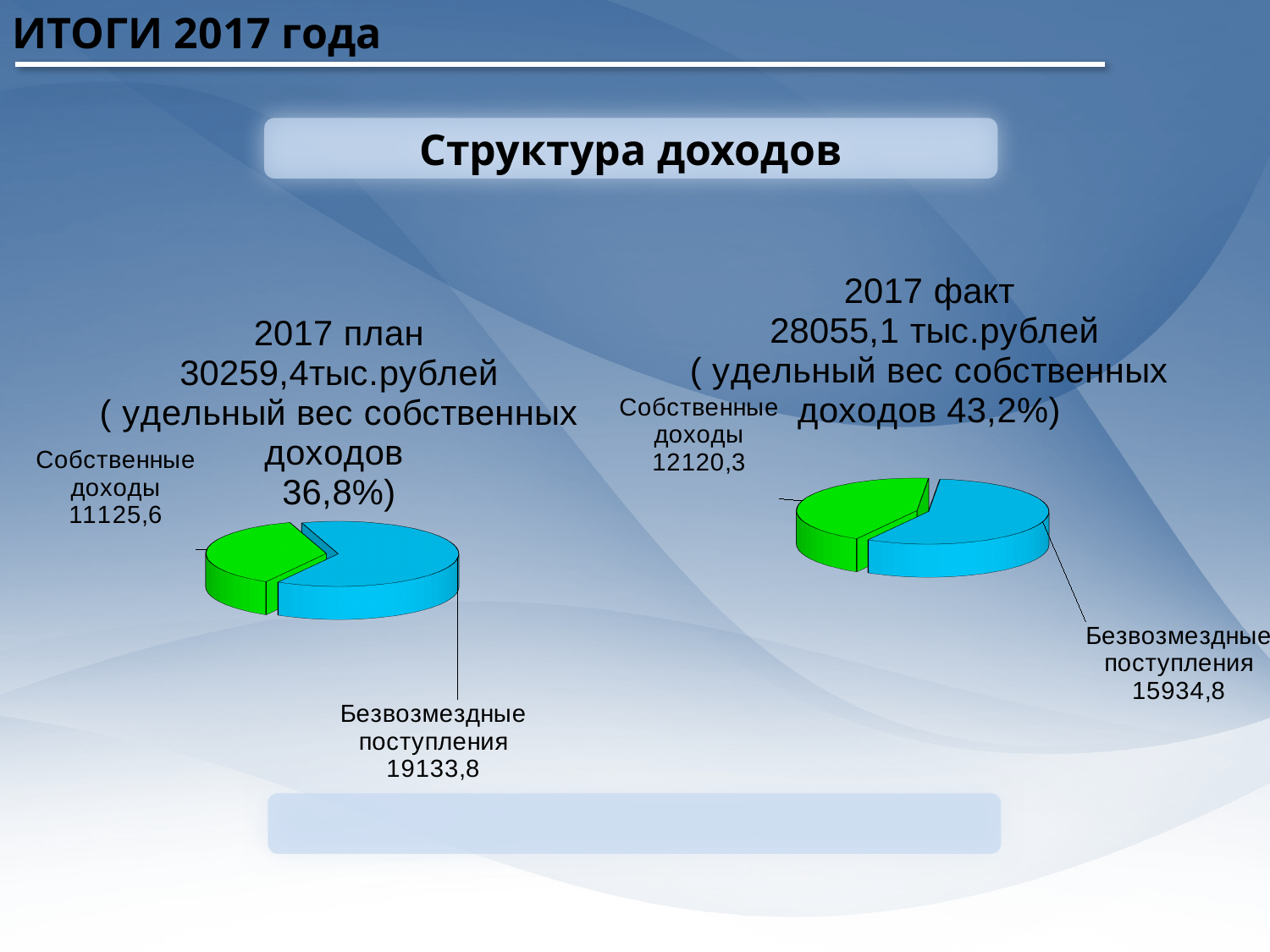
Which is larger: Собственные доходы in the '2017 план' chart or Собственные доходы in the '2017 факт' chart? 2017 факт In the '2017 план' pie chart, what is the value for Собственные доходы? 11125,6 In the '2017 план' pie chart, which slice is the largest? Безвозмездные поступления In the '2017 план' pie chart, what is the value for Безвозмездные поступления? 19133,8 In the '2017 план' pie chart, what is the difference between Безвозмездные поступления and Собственные доходы? 8008,2 What kind of chart is used for '2017 факт'? Pie chart In the '2017 факт' pie chart, what is the value for Собственные доходы? 12120,3 In the '2017 факт' pie chart, which slice is the smallest? Собственные доходы What share of the '2017 факт' pie do Собственные доходы make up, as stated on the slide? 43,2% In the '2017 факт' pie chart, what is the difference between Безвозмездные поступления and Собственные доходы? 3814,5 In the '2017 факт' pie chart, what is the value for Безвозмездные поступления? 15934,8 What share of the '2017 план' pie do Собственные доходы make up, as stated on the slide? 36,8%